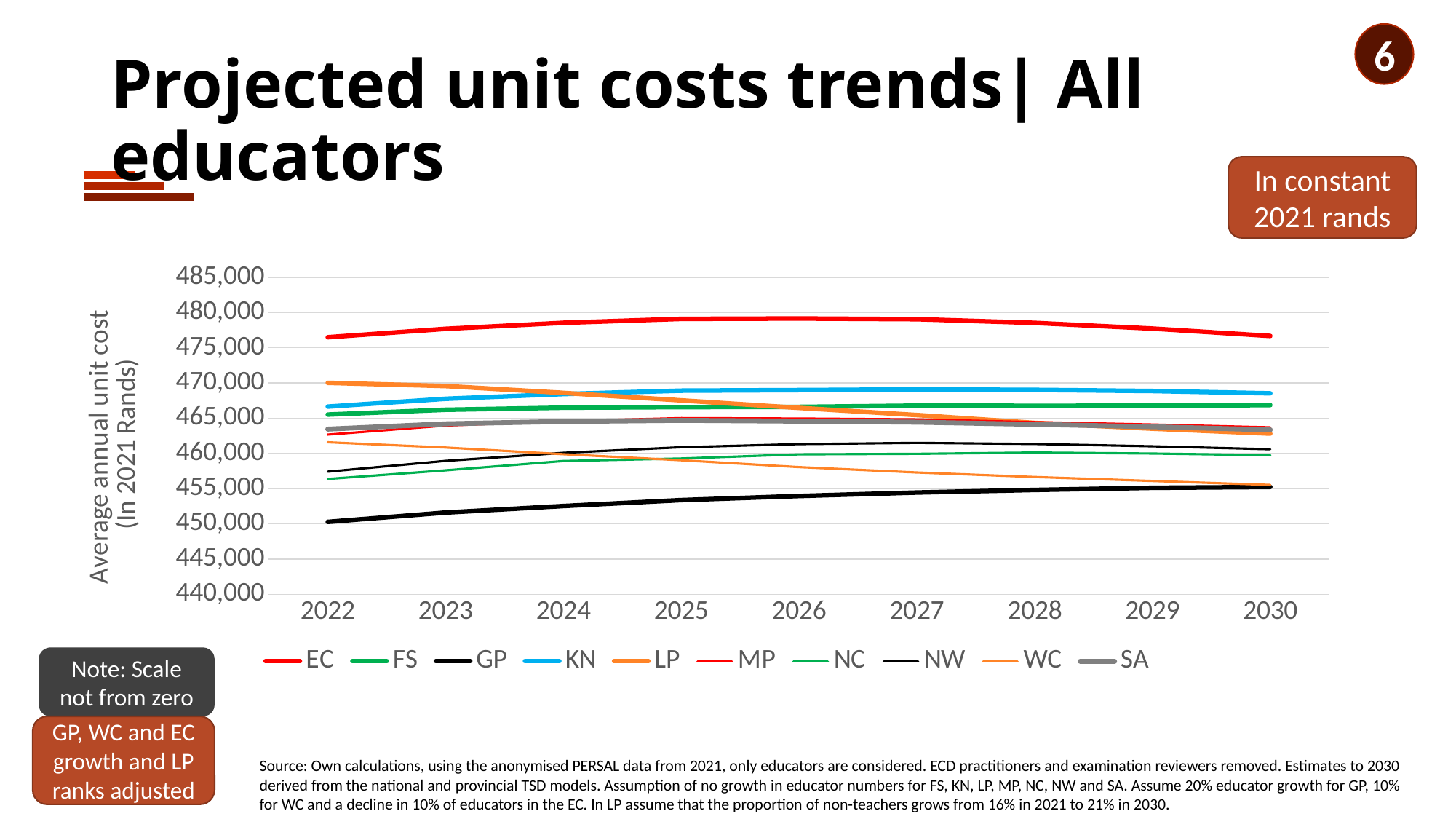
What kind of chart is shown on the slide? Line chart What is the label on the vertical axis? Average annual unit cost (In 2021 Rands) Which province has the lowest projected average annual unit cost in 2022? GP Does the GP line rise or fall from 2022 to 2030? Rises Is the value for LP in 2022 greater or less than 465,000? greater How many series does the legend list? 10 Does the LP line rise or fall from 2022 to 2030? Falls Which province has the highest projected average annual unit cost across the whole period? EC How many years are shown along the x axis? 9 Is the value for EC in 2022 greater or less than 475,000? greater Which is larger in 2030, the value for EC or the value for GP? EC Is the value for GP in 2022 greater or less than 455,000? less